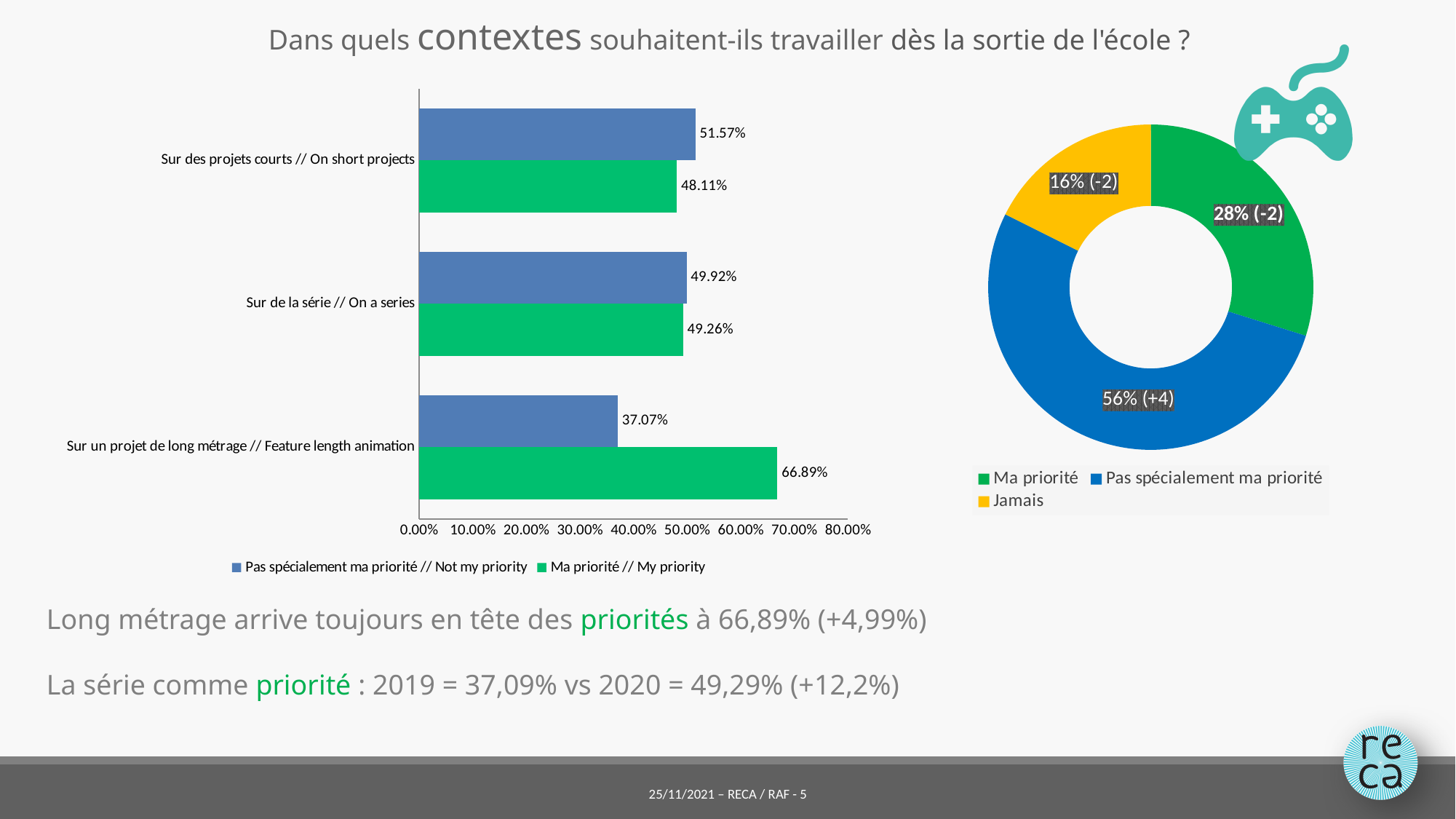
In the bar chart on the left, what is the difference between the 'Ma priorité // My priority' and 'Pas spécialement ma priorité // Not my priority' values for 'Sur un projet de long métrage // Feature length animation'? 29.82% How many series does the legend of the bar chart on the left list? 2 In the doughnut chart on the right, which category has the smallest share? Jamais How many categories are shown in the bar chart on the left? 3 In the bar chart on the left, what is the value of 'Pas spécialement ma priorité // Not my priority' for 'Sur des projets courts // On short projects'? 51.57% In the bar chart on the left, for 'Sur des projets courts // On short projects', which series has the larger value? Pas spécialement ma priorité // Not my priority In the bar chart on the left, which category has the lowest value for 'Pas spécialement ma priorité // Not my priority'? Sur un projet de long métrage // Feature length animation In the doughnut chart on the right, what is the share labelled for 'Pas spécialement ma priorité'? 56% (+4) What type of chart is the chart on the left of the slide? Bar chart In the bar chart on the left, what is the value of 'Ma priorité // My priority' for 'Sur un projet de long métrage // Feature length animation'? 66.89% In the bar chart on the left, what is the value of 'Ma priorité // My priority' for 'Sur de la série // On a series'? 49.26% In the bar chart on the left, which category has the highest value for 'Ma priorité // My priority'? Sur un projet de long métrage // Feature length animation